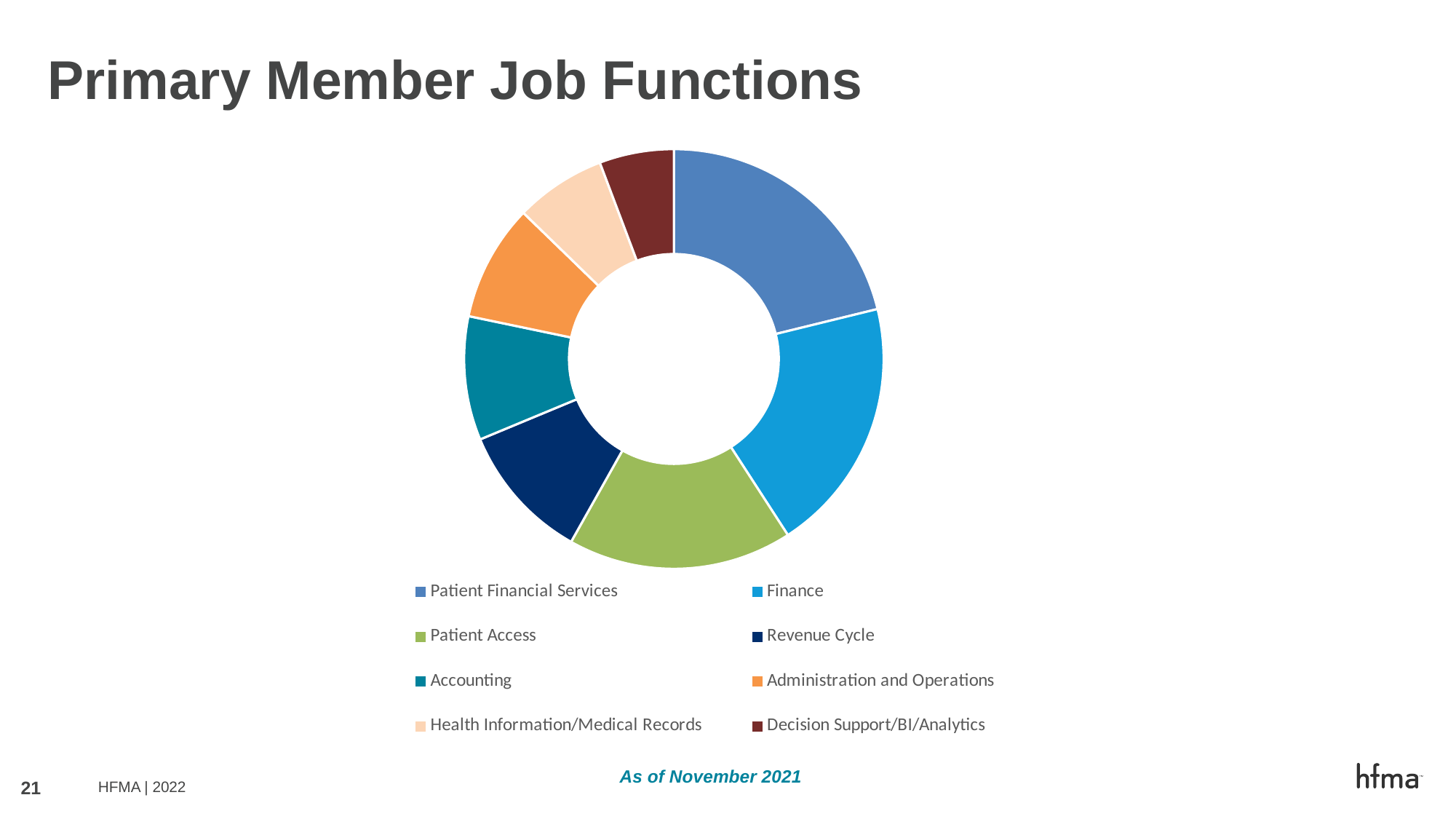
What is the title of the chart on the slide? Primary Member Job Functions What kind of chart is shown on the slide? Pie chart (donut) Which slice is larger: Patient Financial Services or Health Information/Medical Records? Patient Financial Services Which slice is larger: Patient Access or Decision Support/BI/Analytics? Patient Access How many job function categories does the chart show? 8 Which slice is larger: Finance or Accounting? Finance Which job function is shown in green in the chart? Patient Access As of what date is the chart data reported? As of November 2021 Which job function has the smallest slice in the chart? Decision Support/BI/Analytics